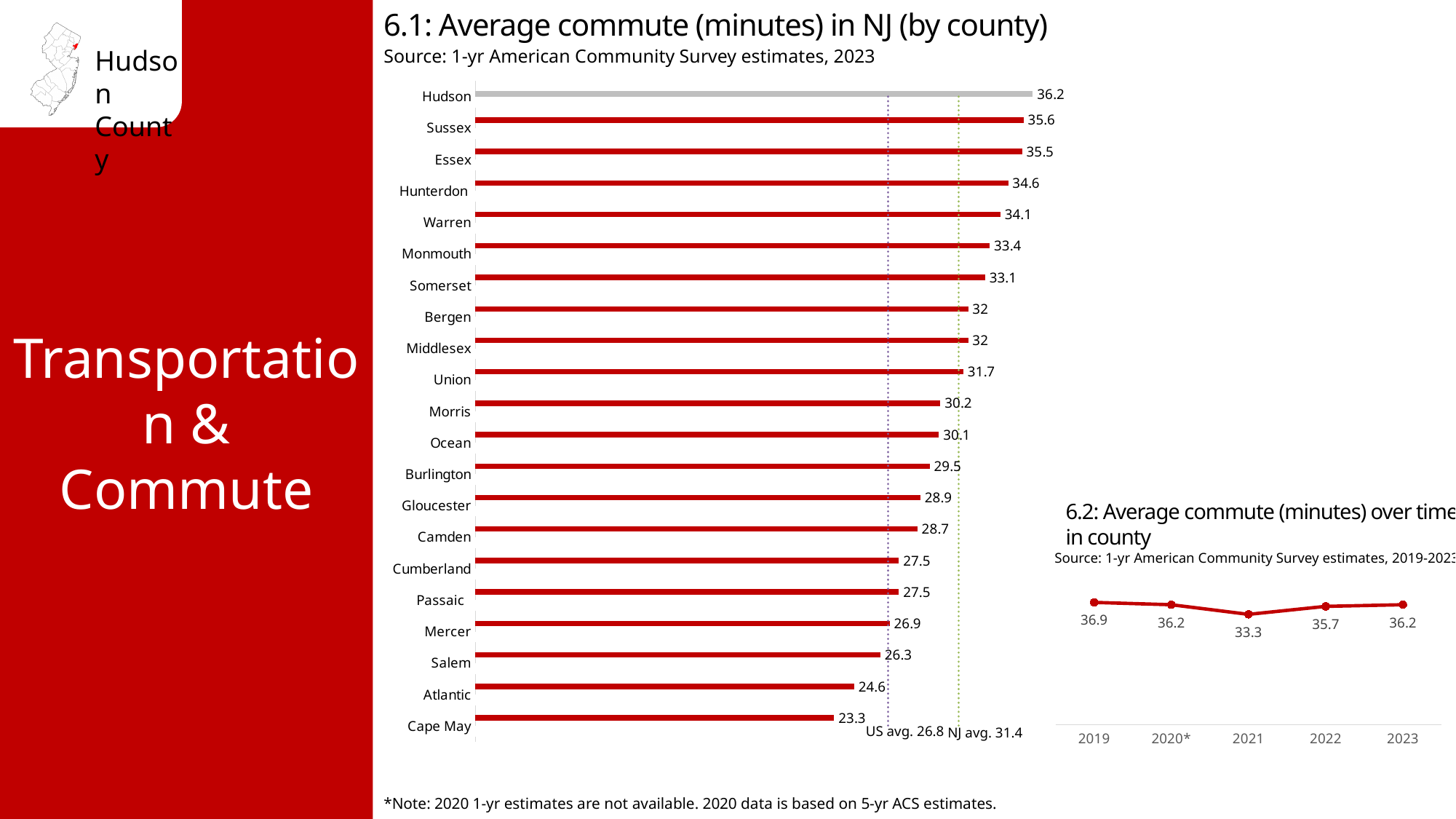
In chart 6.2 (Average commute over time in county), what is the difference between the 2019 and 2021 values? 3.6 In chart 6.1 (Average commute in NJ by county), which county has the lowest average commute? Cape May In chart 6.1 (Average commute in NJ by county), what is the average commute for Bergen? 32 In chart 6.1 (Average commute in NJ by county), which has a longer average commute, Morris or Mercer? Morris In chart 6.2 (Average commute over time in county), what was the average commute in 2021? 33.3 In chart 6.2 (Average commute over time in county), which year had the highest average commute? 2019 In chart 6.1 (Average commute in NJ by county), what is the NJ average commute shown by the reference line? 31.4 In chart 6.1 (Average commute in NJ by county), what is the difference between Hudson's and Cape May's average commute? 12.9 In chart 6.1 (Average commute in NJ by county), which county has the highest average commute? Hudson In chart 6.1 (Average commute in NJ by county), what is the average commute for Hudson? 36.2 What type of chart is chart 6.1 (Average commute in NJ by county)? Bar chart In chart 6.1 (Average commute in NJ by county), how many counties are shown? 21